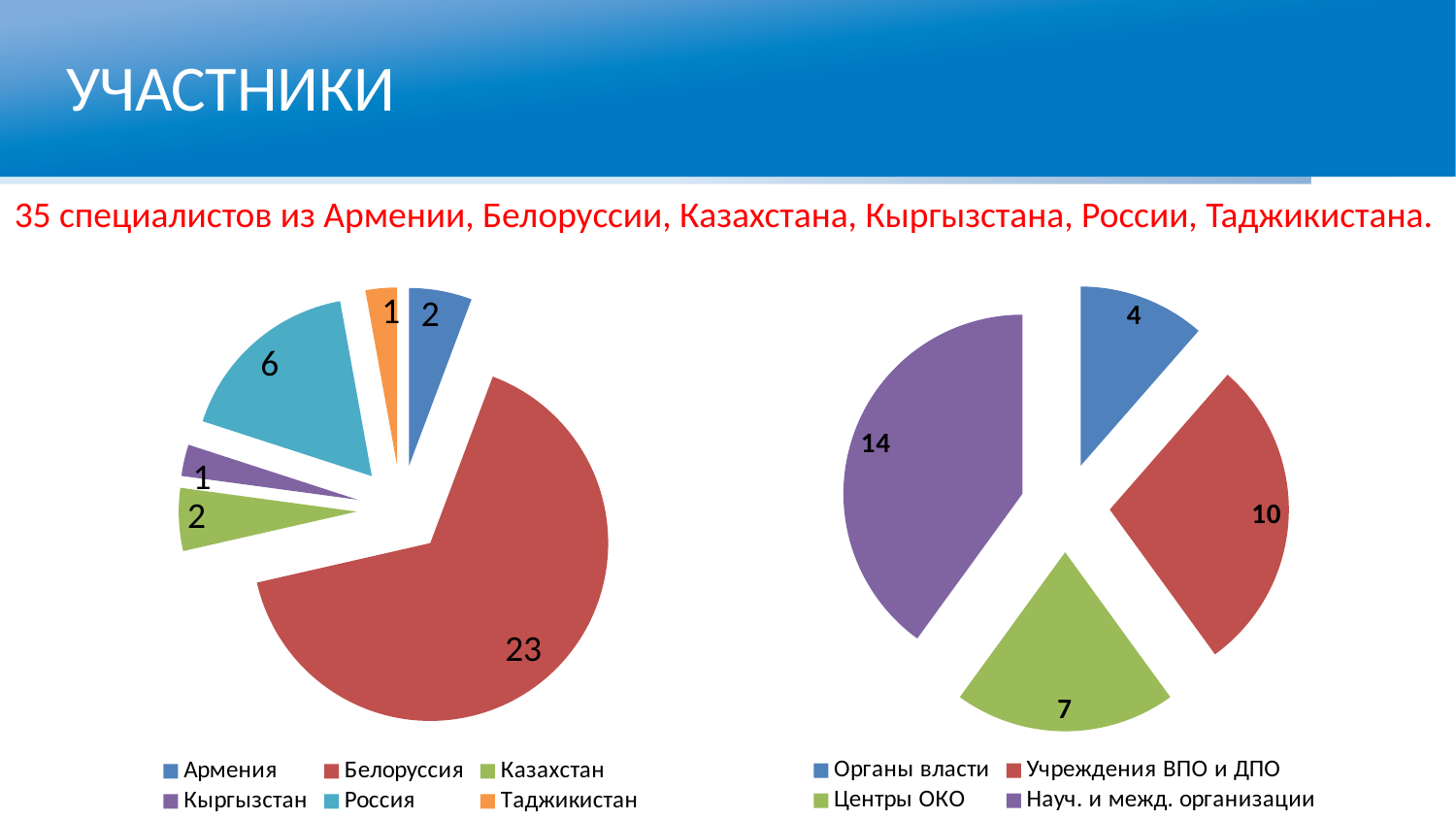
In the left pie chart, what is the value for Россия? 6 How many categories does the right pie chart show? 4 In the right pie chart, which category has the smallest slice? Органы власти In the right pie chart, what is the difference between Науч. и межд. организации and Органы власти? 10 In the right pie chart, what is the value for Центры ОКО? 7 In the left pie chart, what is the value for Белоруссия? 23 In the right pie chart, what is the value for Учреждения ВПО и ДПО? 10 In the right pie chart, what share of the total does Науч. и межд. организации represent? 40% How many categories does the left pie chart show? 6 In the left pie chart, which is larger, Россия or Армения? Россия In the left pie chart, which category has the largest slice? Белоруссия What type of chart is the right chart? Pie chart